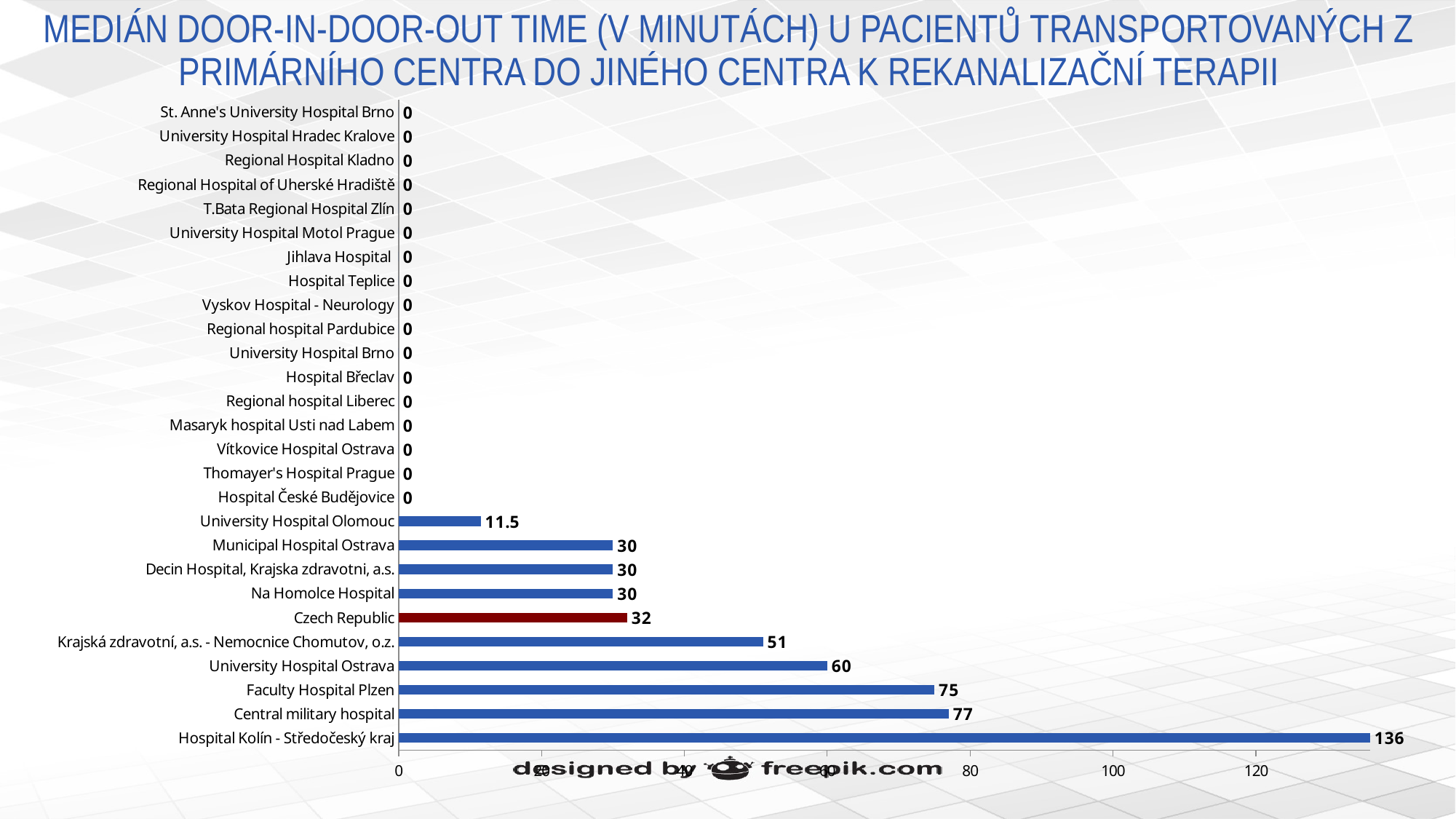
What is the value shown for University Hospital Olomouc? 11.5 What is the value shown for Faculty Hospital Plzen? 75 Is the value for University Hospital Ostrava greater or less than 40? greater What kind of chart is shown on the slide? bar chart How many hospitals/categories are listed on the chart? 27 What is the value shown for Czech Republic? 32 Which is larger, the value for Krajská zdravotní, a.s. - Nemocnice Chomutov, o.z. or the value for Na Homolce Hospital? Krajská zdravotní, a.s. - Nemocnice Chomutov, o.z. Which category's bar is drawn in a different colour (dark red) from the others? Czech Republic What is the difference between the values for Hospital Kolín - Středočeský kraj and Czech Republic? 104 What is the median door-in-door-out time for Hospital Kolín - Středočeský kraj? 136 What is the difference between the values for Central military hospital and University Hospital Ostrava? 17 Which hospital has the highest median door-in-door-out time? Hospital Kolín - Středočeský kraj